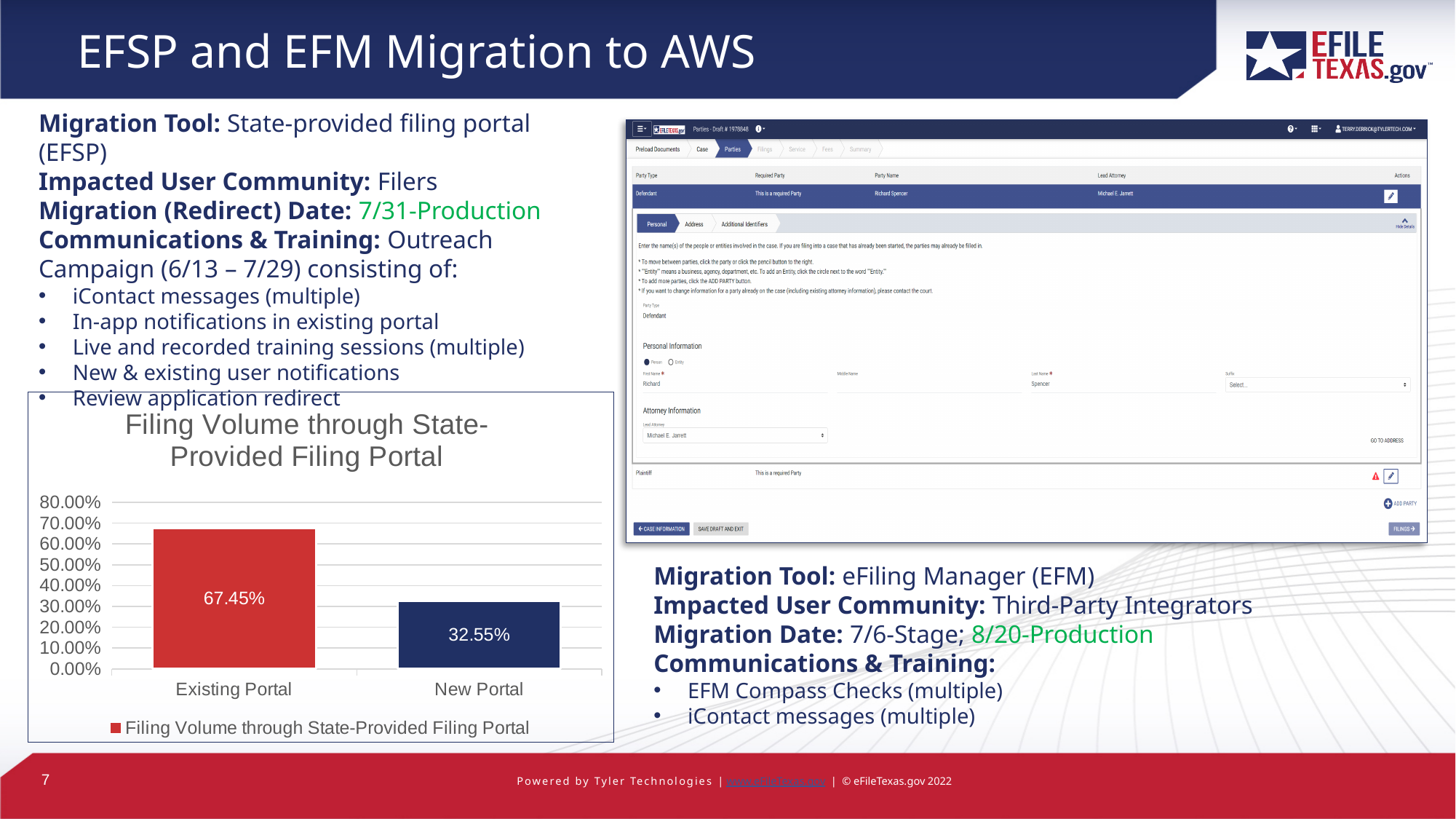
How many categories are shown on the x axis of the chart? 2 Which category has the lowest value in the Filing Volume through State-Provided Filing Portal chart? New Portal Which is larger in the chart, the value for Existing Portal or the value for New Portal? Existing Portal What kind of chart is shown on the slide? Bar chart Is the value for Existing Portal greater or less than 60.00%? greater What is the difference between the Existing Portal and New Portal values in the chart? 34.90% How many series does the chart legend list? 1 What is the value for New Portal in the Filing Volume through State-Provided Filing Portal chart? 32.55% Is the value for New Portal greater or less than 40.00%? less Which category has the highest value in the Filing Volume through State-Provided Filing Portal chart? Existing Portal What is the value for Existing Portal in the Filing Volume through State-Provided Filing Portal chart? 67.45% What is the title of the chart on the slide? Filing Volume through State-Provided Filing Portal